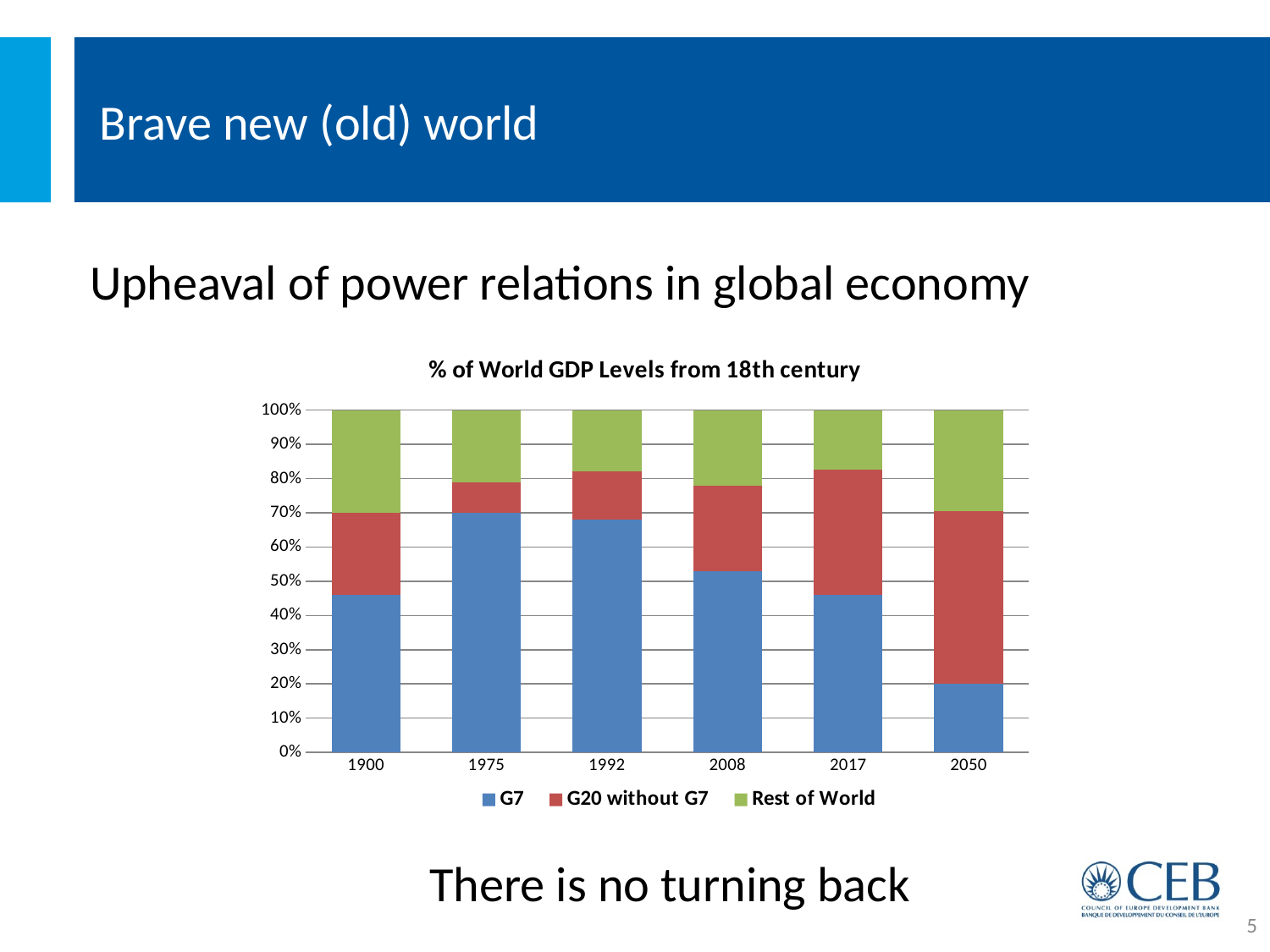
Does the G7 share rise or fall from 2008 to 2050? fall What kind of chart is shown on the slide? Stacked bar chart How many series does the legend list? 3 Which year has a larger G7 share, 2008 or 2050? 2008 In which year is the G7 share of world GDP the lowest? 2050 Which year has a larger Rest of World share, 2017 or 2050? 2050 Is the G7 share for 1975 greater or less than 60%? greater Is the G7 share for 1900 greater or less than 50%? less Which series is shown in green in the chart? Rest of World What is the title of the chart? % of World GDP Levels from 18th century How many years are shown on the x axis of the chart? 6 Is the G7 share for 2050 greater or less than 30%? less